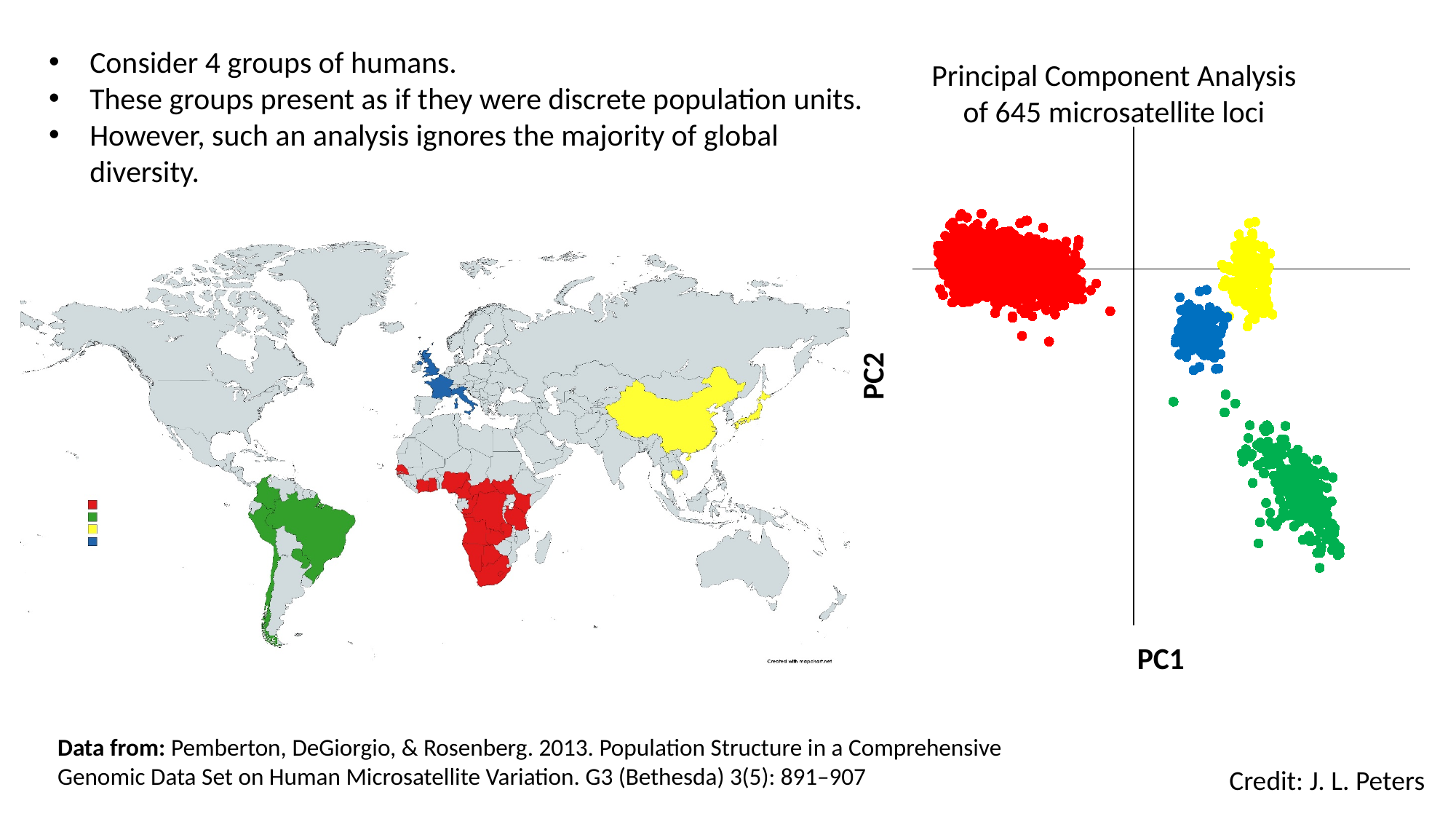
In the Principal Component Analysis chart, which cluster has higher PC2 values, the yellow cluster or the blue cluster? yellow In the Principal Component Analysis chart, which coloured cluster lies lowest along PC2? green In the Principal Component Analysis chart, which cluster has higher PC2 values, the blue cluster or the green cluster? blue In the Principal Component Analysis chart, what is the label of the horizontal axis? PC1 In the Principal Component Analysis chart, which cluster has higher PC1 values, the blue cluster or the yellow cluster? yellow What kind of chart is the Principal Component Analysis chart on the right of the slide? scatter plot What is the title of the chart on the right of the slide? Principal Component Analysis of 645 microsatellite loci In the Principal Component Analysis chart, which coloured cluster lies furthest to the right along PC1? green How many distinct coloured clusters of points are plotted in the Principal Component Analysis chart? 4 In the Principal Component Analysis chart, which coloured cluster lies furthest to the left along PC1? red